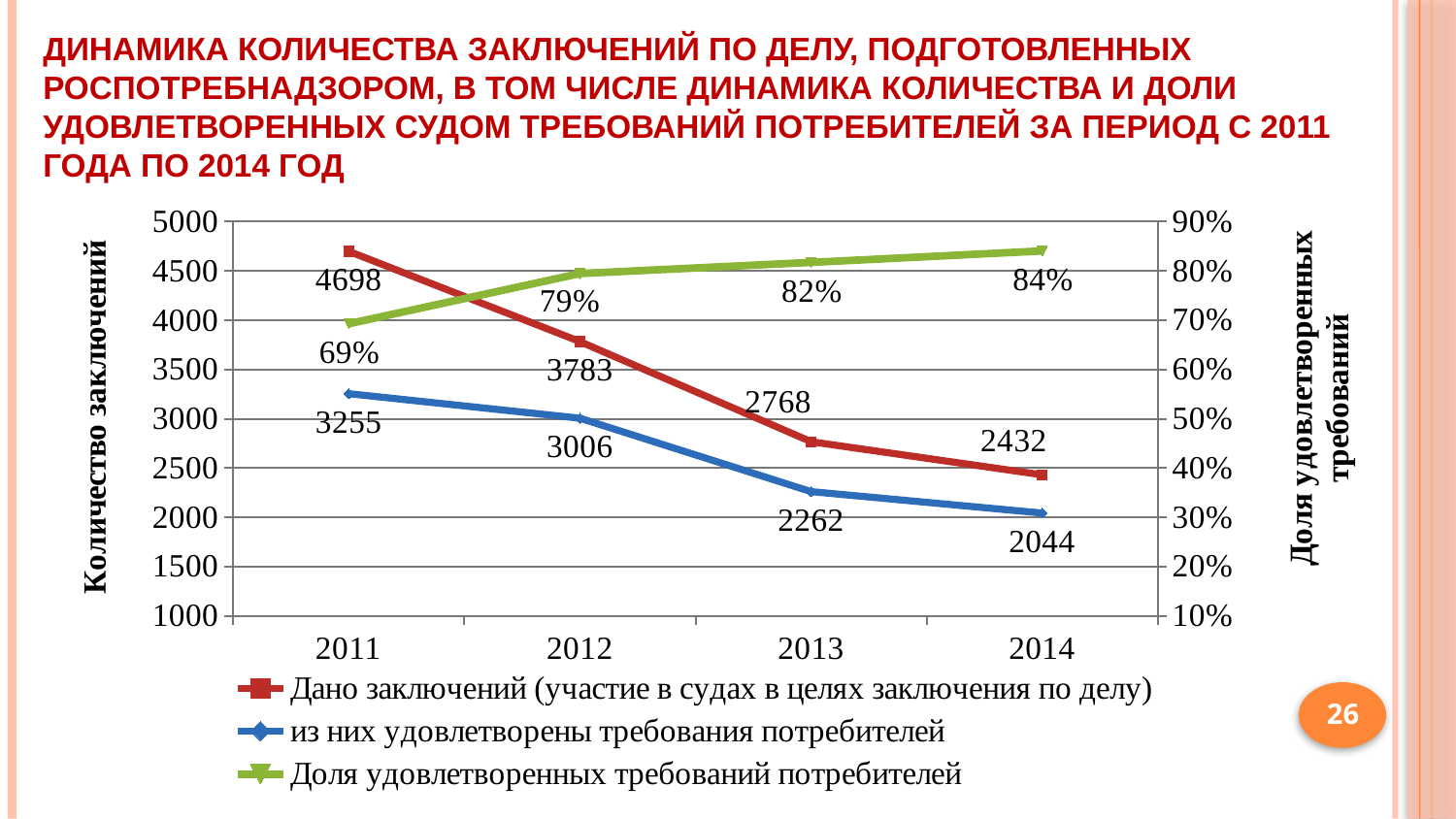
What is the 'Доля удовлетворенных требований потребителей' in 2014? 84% How many series does the legend list? 3 Which is larger: 'Дано заключений' in 2013 or 'из них удовлетворены требования потребителей' in 2012? из них удовлетворены требования потребителей in 2012 What is the value of 'из них удовлетворены требования потребителей' in 2013? 2262 Does 'Дано заключений' rise or fall from 2011 to 2014? fall How many years are shown on the x axis? 4 In which year is 'Дано заключений' lowest? 2014 In which year is 'Доля удовлетворенных требований потребителей' highest? 2014 What is the value of 'Дано заключений' in 2011? 4698 What colour is the line for 'Доля удовлетворенных требований потребителей'? green What type of chart is shown on the slide? line chart What is the difference between 'Дано заключений' in 2011 and 2012? 915